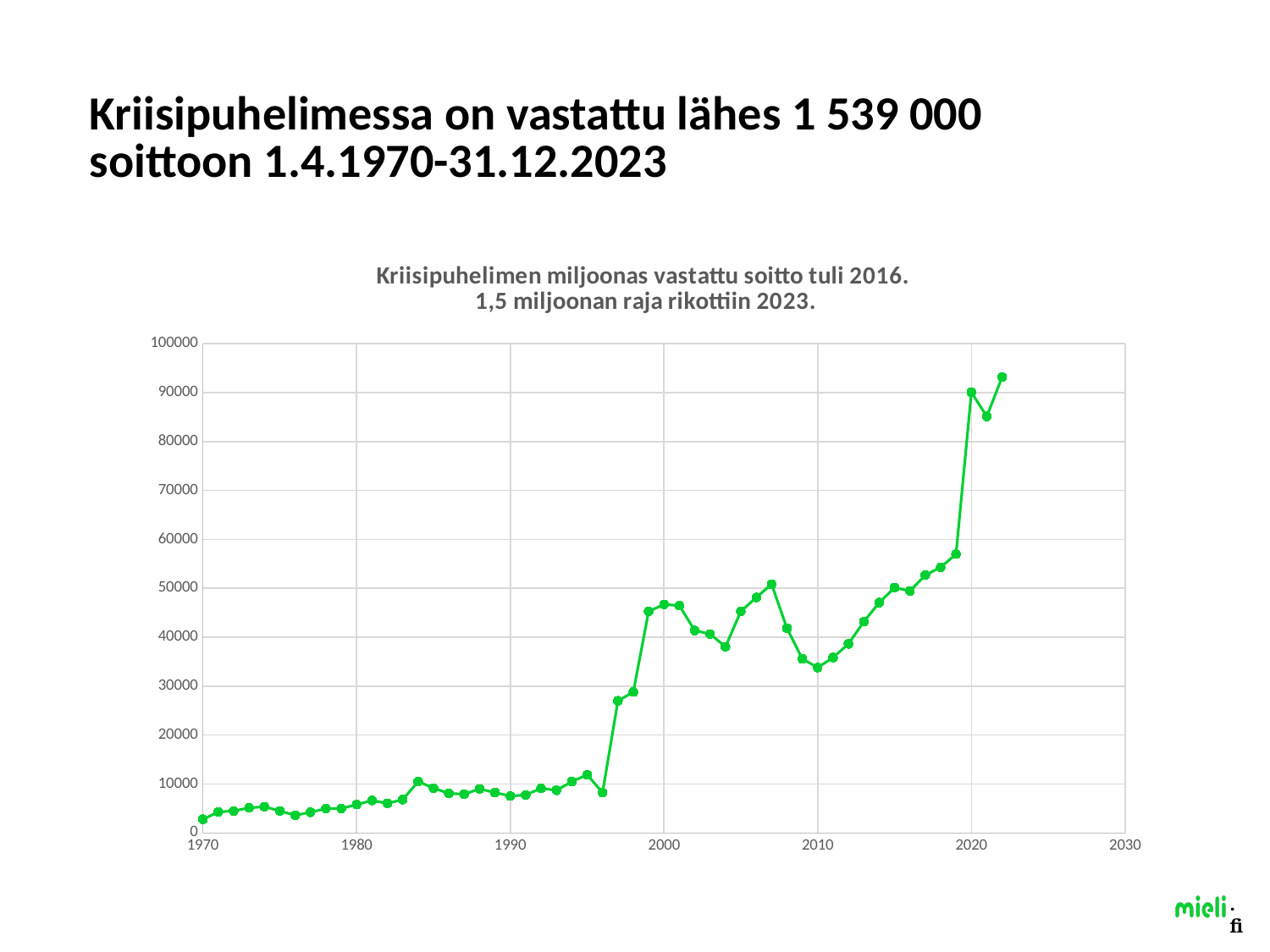
Is the value for 2000 greater or less than 40000? greater Do the values generally rise or fall from 1970 to 2020? rise Which is larger, the value for 2020 or the value for 2000? 2020 Is the value for 2020 greater or less than 80000? greater Is the value for 1990 greater or less than 10000? less Do the values generally rise or fall between 2000 and 2010? fall What is the title of the chart? Kriisipuhelimen miljoonas vastattu soitto tuli 2016. 1,5 miljoonan raja rikottiin 2023. Which is larger, the value for 2000 or the value for 2010? 2000 What colour is the plotted line? green What kind of chart is shown on the slide? line chart